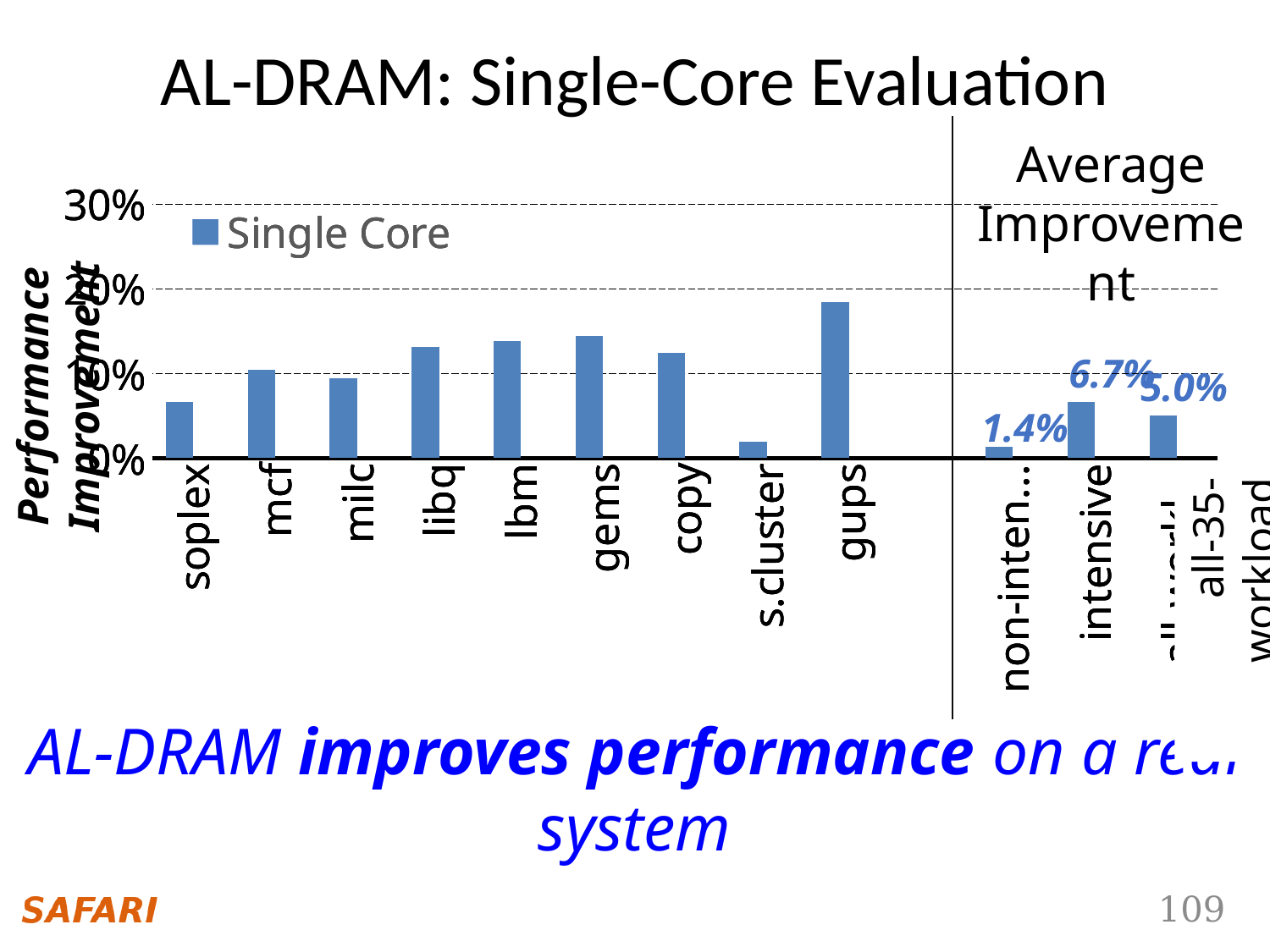
Among the individual workloads from soplex to gups, which has the lowest performance improvement? s.cluster What is the difference between the intensive and non-intensive average improvements? 5.3% What value is labelled on the rightmost bar (all-35-workload)? 5.0% Which workload has the highest performance improvement in the chart? gups What is the average performance improvement shown for the non-intensive workloads? 1.4% Which has a larger performance improvement, gups or soplex? gups Which has a larger performance improvement, libq or mcf? libq How many series does the legend list? 1 What kind of chart is shown on the slide? bar chart What is the average performance improvement shown for the intensive workloads? 6.7% How many categories are plotted along the x axis? 12 Is the performance improvement for gups greater or less than 30%? less